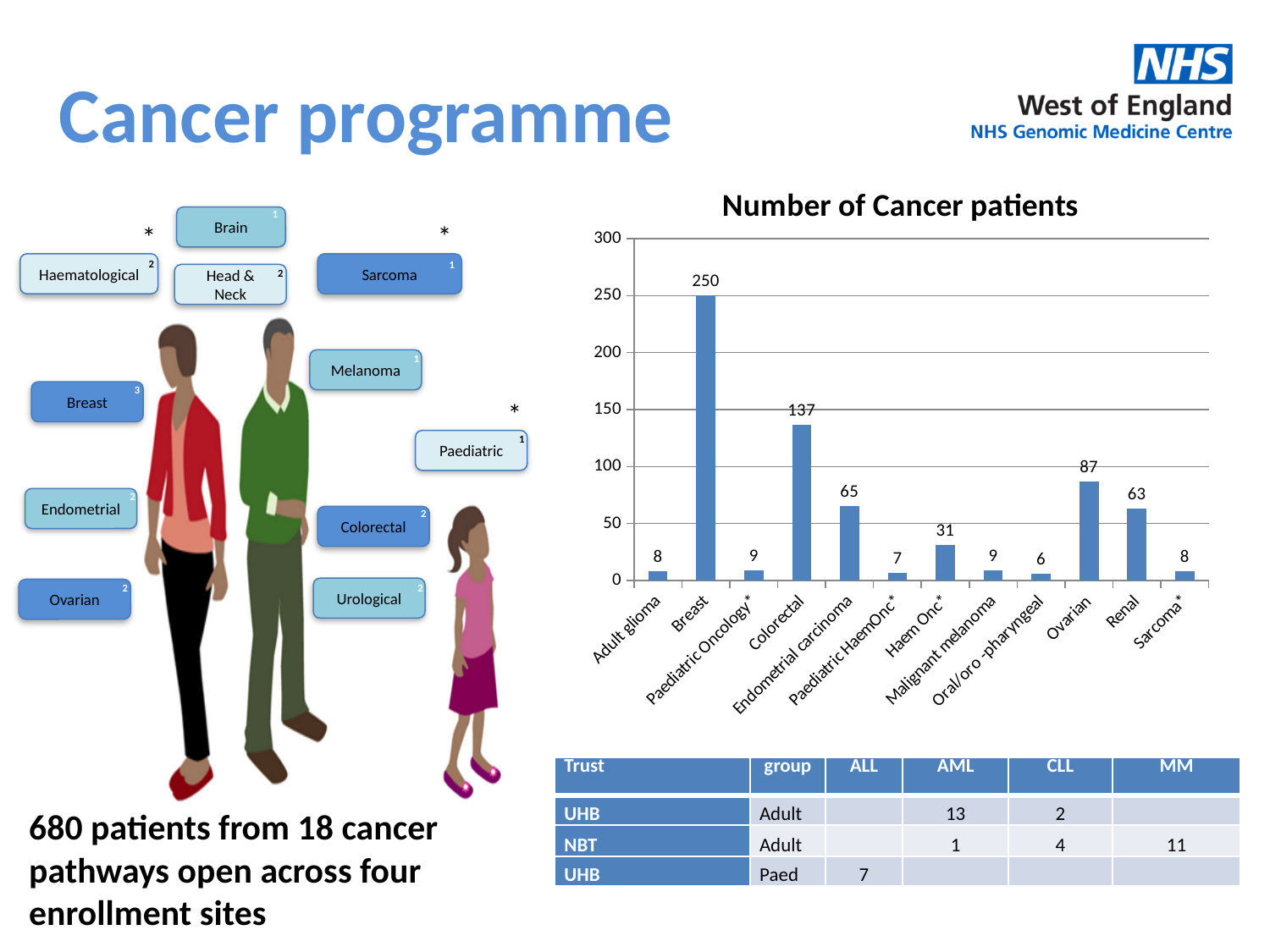
Which category has the highest number of cancer patients? Breast What is the number of cancer patients for Colorectal? 137 What is the number of cancer patients for Ovarian? 87 Which category has the lowest number of cancer patients? Oral/oro-pharyngeal What is the number of cancer patients for Breast? 250 What kind of chart is used to show the number of cancer patients? Bar chart What is the title of the chart? Number of Cancer patients What is the difference between the number of patients for Ovarian and Renal? 24 What is the number of cancer patients for Haem Onc*? 31 Which has more patients, Endometrial carcinoma or Renal? Endometrial carcinoma How many categories are shown on the x axis of the chart? 12 What is the difference between the number of patients for Breast and Colorectal? 113